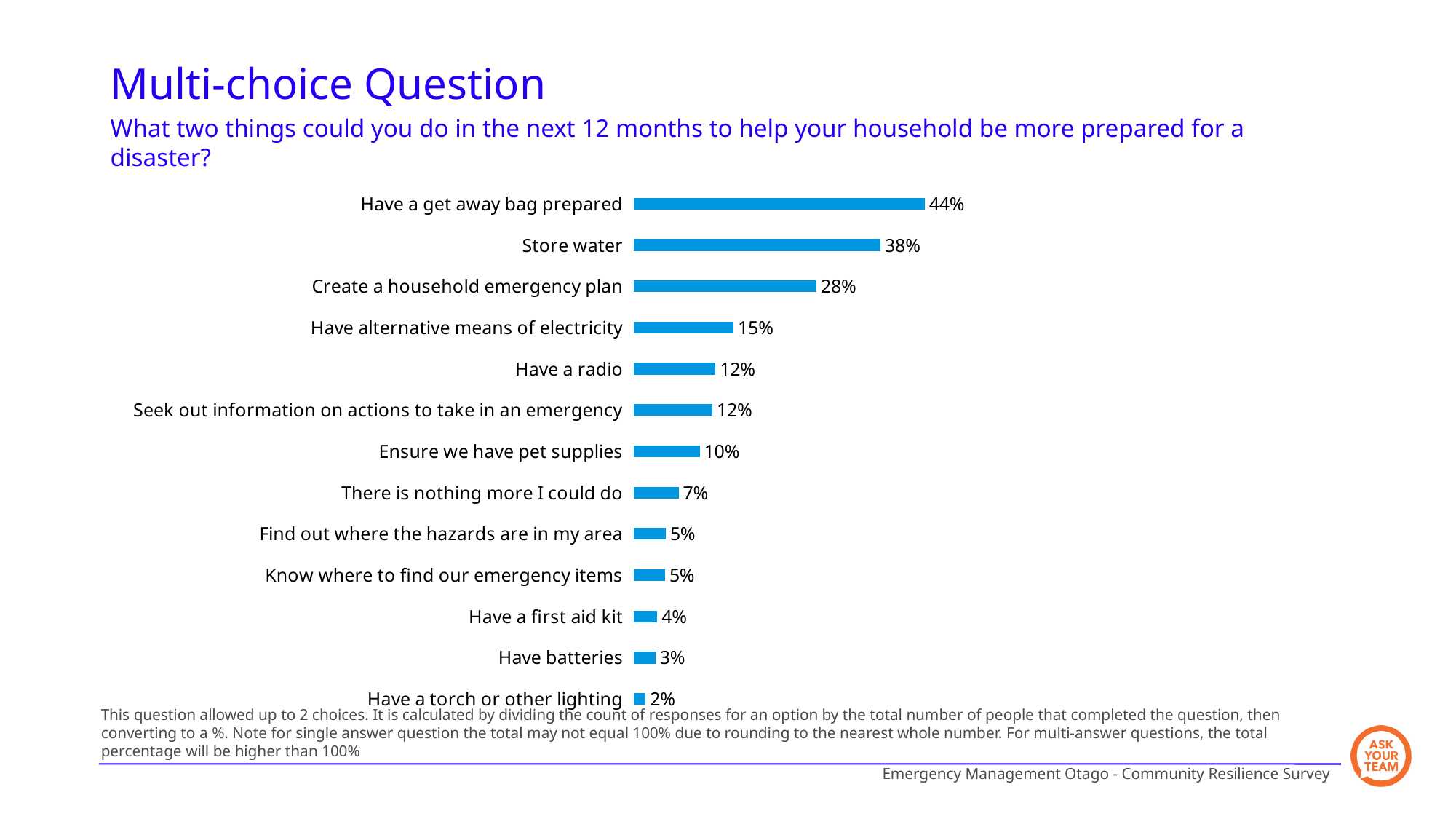
What is the difference between 'Have a get away bag prepared' and 'Store water'? 6% What is the value for 'Ensure we have pet supplies'? 10% Which is larger: 'There is nothing more I could do' or 'Have a first aid kit'? There is nothing more I could do What percentage of respondents chose 'Have a get away bag prepared'? 44% How many options are shown in the chart? 13 Which option has the highest percentage? Have a get away bag prepared What percentage is shown for 'Have alternative means of electricity'? 15% What is the value shown for 'Store water'? 38% What is the difference between 'Create a household emergency plan' and 'Have a radio'? 16% What type of chart is shown on the slide? Bar chart What colour are the bars in the chart? Blue Which option has the lowest percentage? Have a torch or other lighting